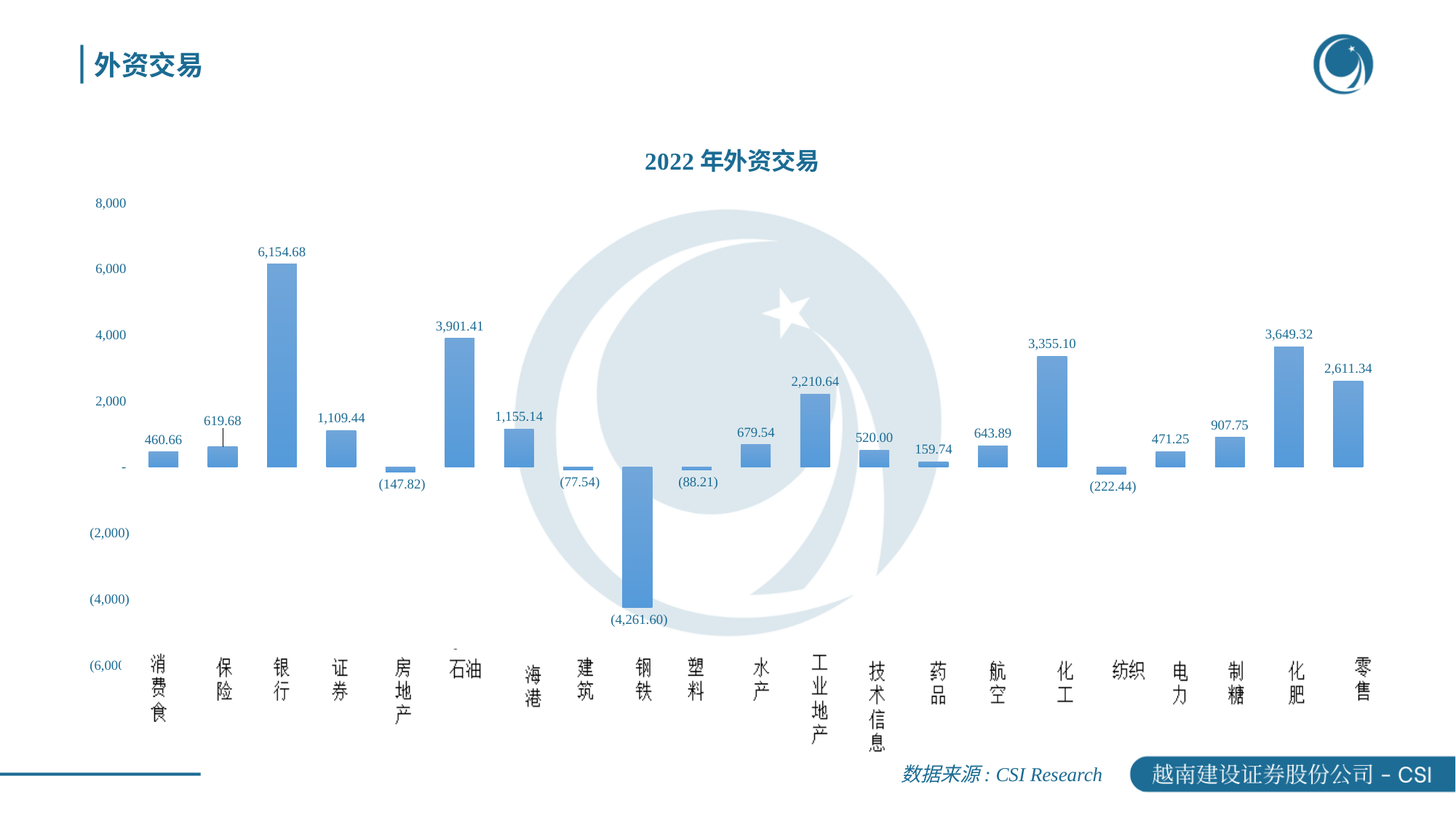
What is the value for 纺织 in the chart? (222.44) Which category has the lowest value in the chart? 钢铁 What is the value for 钢铁 in the chart? (4,261.60) Which is larger, the value for 零售 or the value for 工业地产? 零售 How many categories are shown on the x axis of the chart? 21 What kind of chart is shown on the slide? Bar chart What is the title of the chart? 2022 年外资交易 What is the difference between the values for 石油 and 化工? 546.31 What is the data source stated below the chart? CSI Research What is the value for 银行 in the 2022 年外资交易 chart? 6,154.68 What is the value for 化肥 in the chart? 3,649.32 Which category has the highest value in the chart? 银行